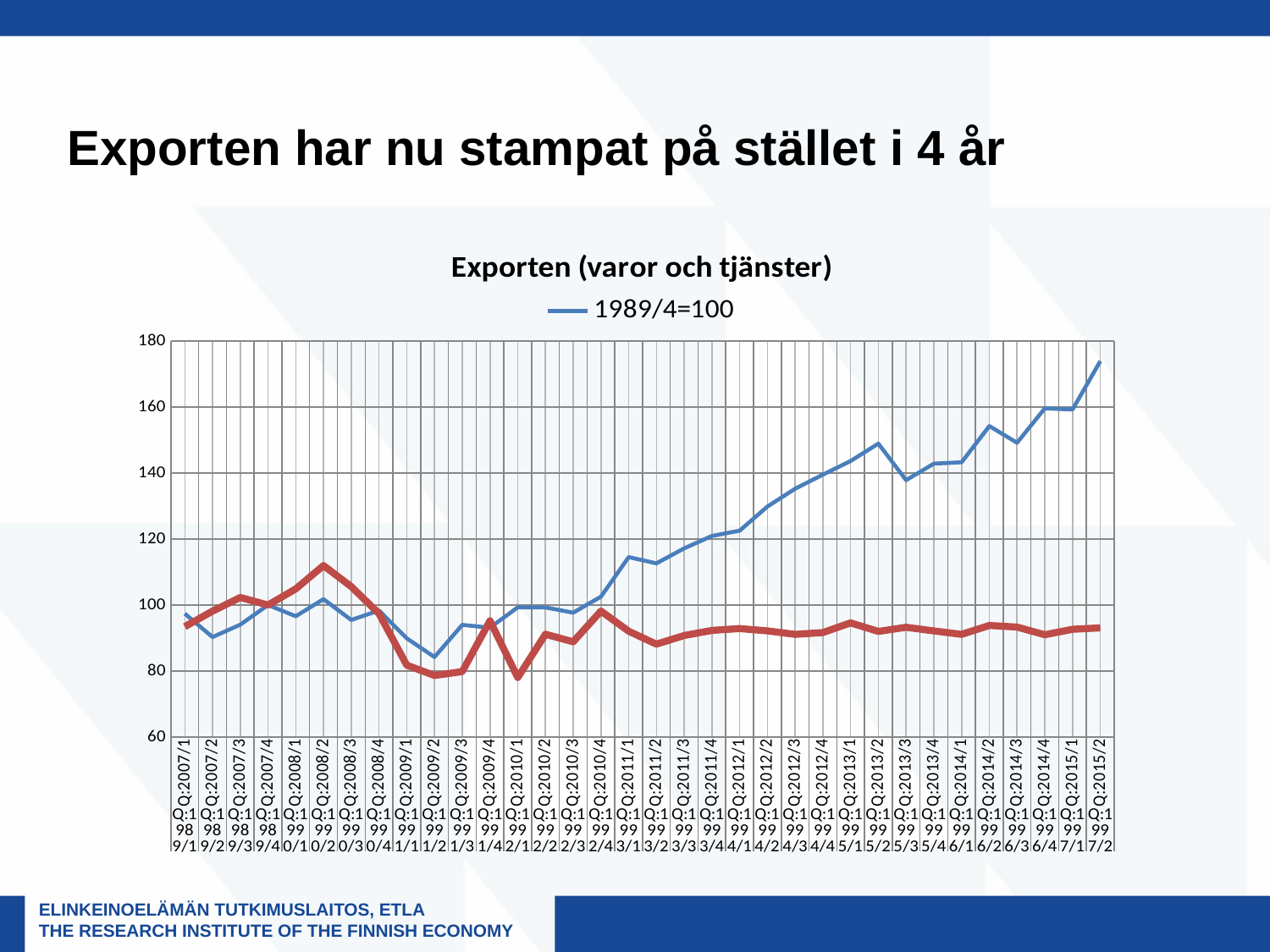
Is the value of the blue line at the last point (Q:2015/2) greater or less than 160? greater How many entries does the chart legend list? 1 Is the value of the blue line at Q:2009/2 greater or less than 100? less What kind of chart is shown on the slide? line chart How many quarterly points are plotted along the x axis (from Q:2007/1 to Q:2015/2)? 34 Is the value of the blue line at Q:2013/2 greater or less than 140? greater What is the legend entry shown above the chart? 1989/4=100 At the last point on the x axis (Q:2015/2), which line has the higher value, the blue line or the red line? the blue line What is the title of the chart? Exporten (varor och tjänster) Does the blue line overall rise or fall from the start to the end of the x axis? rise